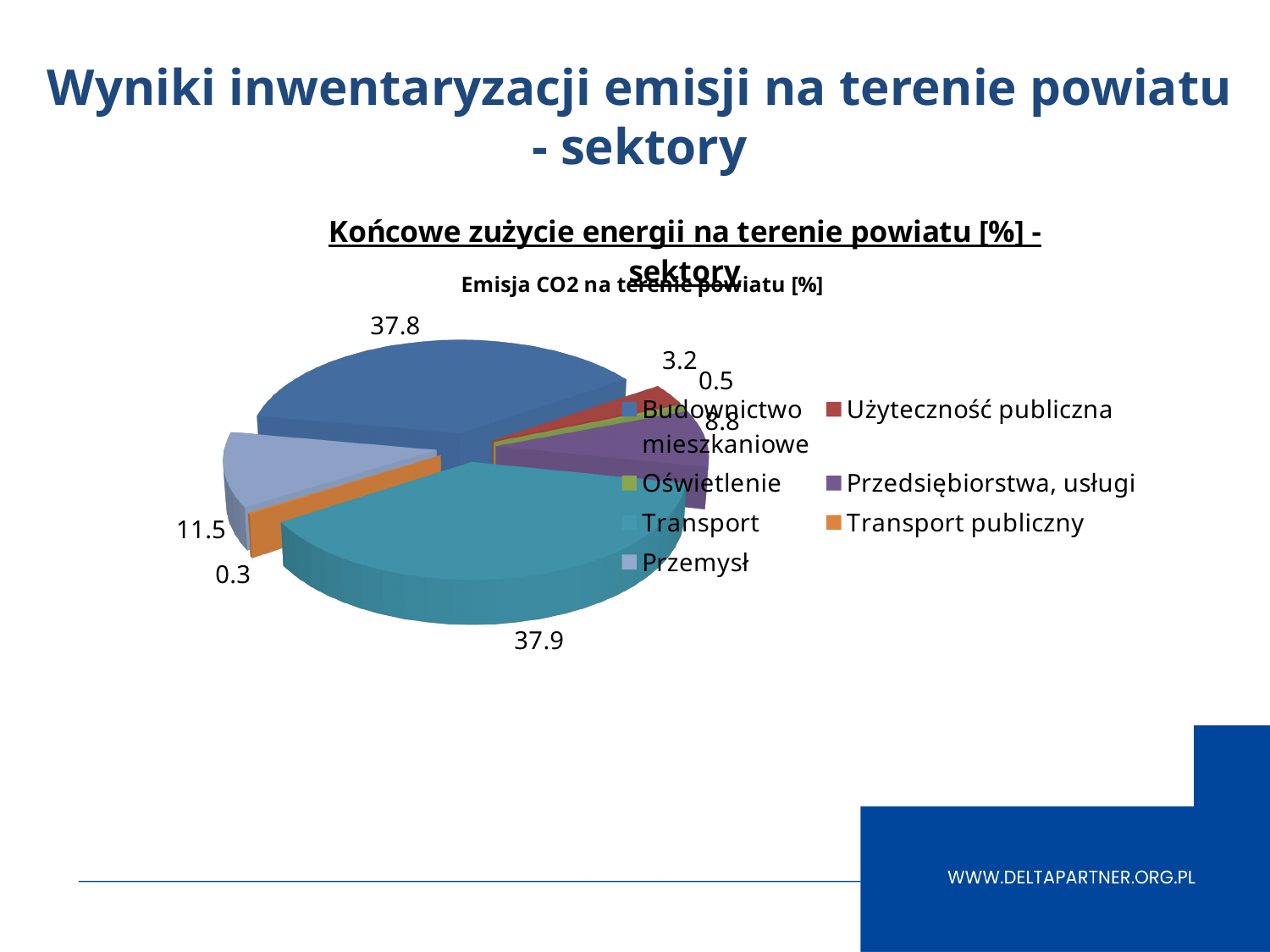
What is the value for Oświetlenie in the pie chart? 0.5 What is the value for Przemysł in the pie chart? 11.5 What is the value for Użyteczność publiczna in the pie chart? 3.2 Which is larger in the pie chart, Przemysł or Przedsiębiorstwa, usługi? Przemysł What is the value for Budownictwo mieszkaniowe in the pie chart? 37.8 How many categories does the pie chart show? 7 What is the value for Transport publiczny in the pie chart? 0.3 What type of chart is shown on the slide? pie chart What is the value for Transport in the pie chart? 37.9 What is the value for Przedsiębiorstwa, usługi in the pie chart? 8.8 What is the title of the pie chart? Końcowe zużycie energii na terenie powiatu [%] - sektory What is the difference between the values for Budownictwo mieszkaniowe and Przemysł? 26.3